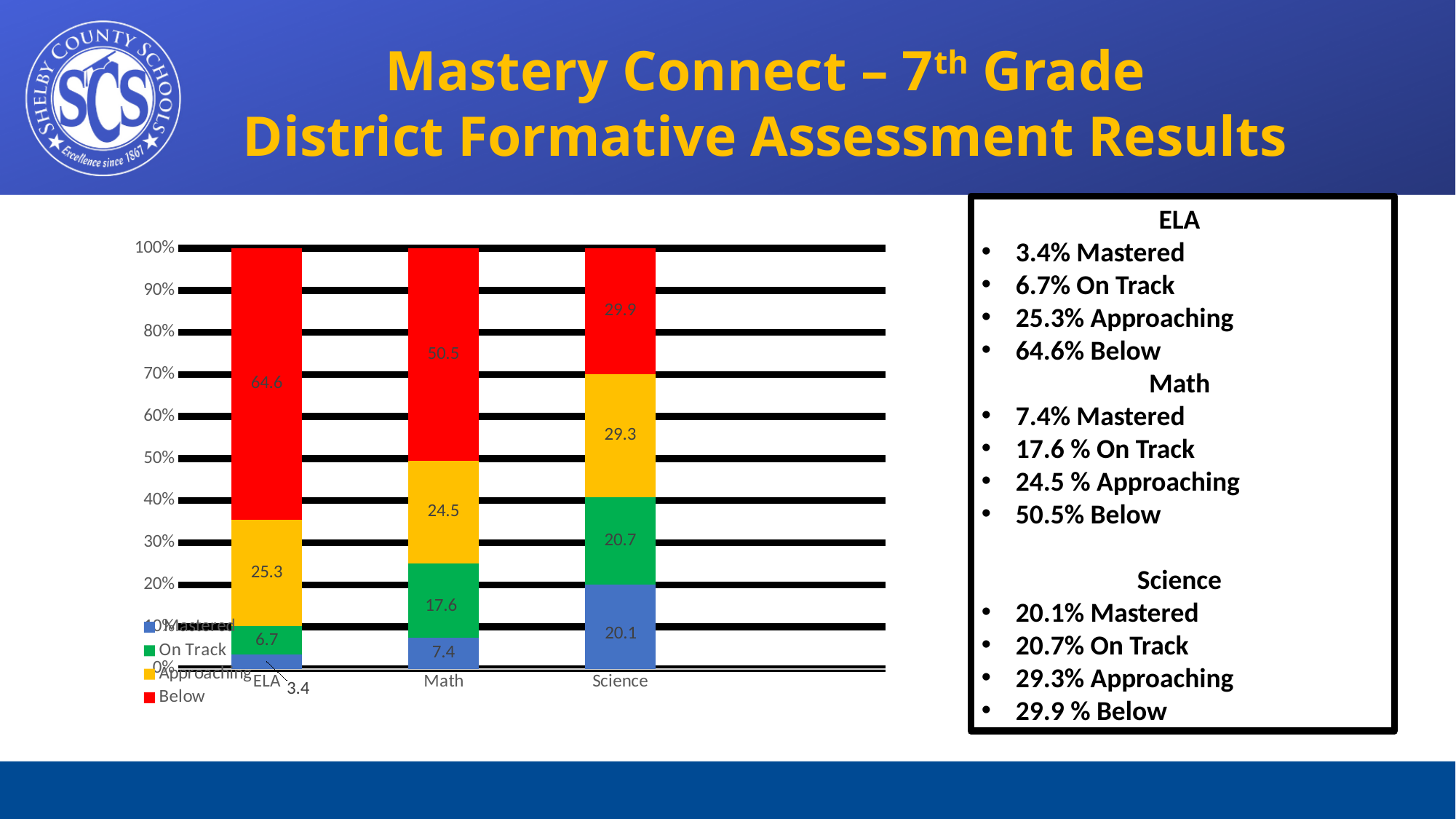
Which subject has the lowest Mastered value? ELA What is the Mastered value for Science? 20.1 What is the Below value for ELA? 64.6 What is the difference between the Below values for ELA and Math? 14.1 Which subject has the highest Below value? ELA Which is larger, the Approaching value for ELA or for Math? ELA Which colour represents the Below series? Red What is the Approaching value for Science? 29.3 What kind of chart is shown on the slide? Stacked bar chart How many subjects are shown on the x axis? 3 How many series does the legend list? 4 What is the On Track value for Math? 17.6